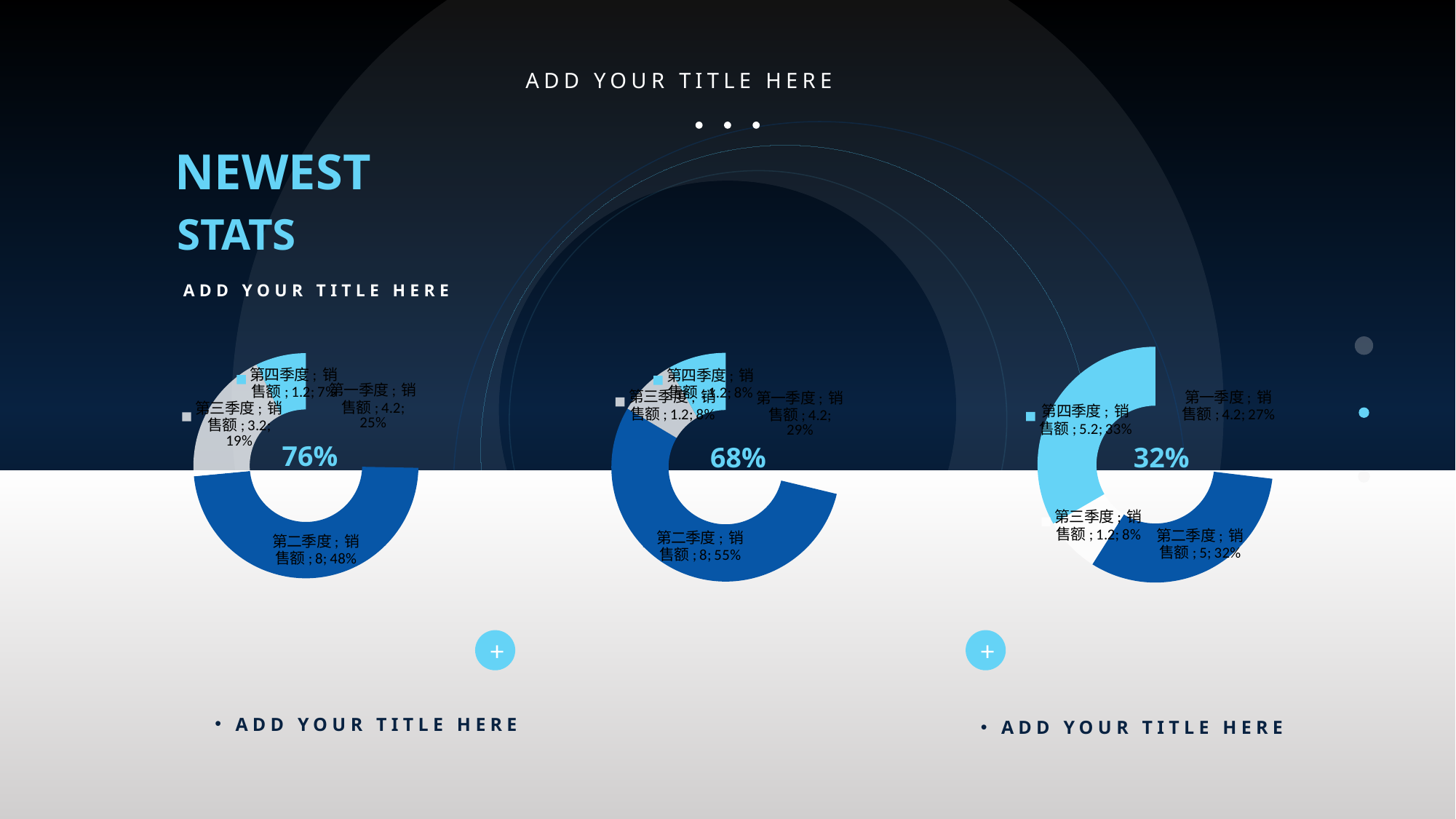
In the right chart, which is larger, the value for 第一季度 or the value for 第三季度? 第一季度 In the middle chart, what is the value for 第一季度? 4.2 In the middle chart, what share of the doughnut does 第二季度 take? 55% What kind of chart is the left chart on the slide? doughnut chart In the left chart, which quarter has the smallest slice? 第四季度 In the left chart, what is the value for 第二季度? 8 In the middle chart, what is the difference between the values for 第二季度 and 第一季度? 3.8 In the left chart, which quarter has the largest slice? 第二季度 In the right chart, what share of the doughnut does 第一季度 take? 27% How many slices does the right chart have? 4 In the right chart, what is the value for 第四季度? 5.2 In the left chart, what share of the doughnut does 第三季度 take? 19%